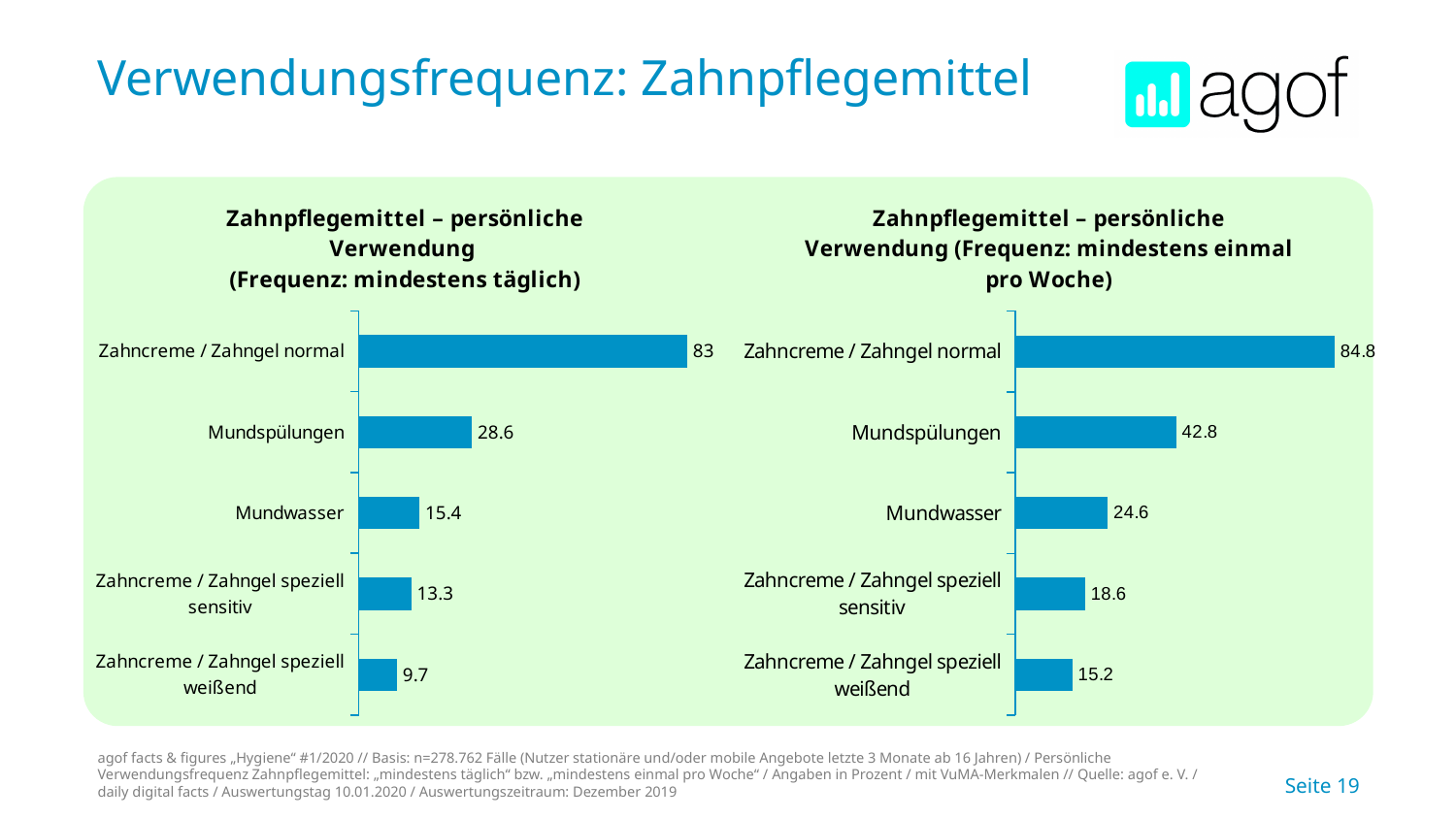
In the right chart (Frequenz: mindestens einmal pro Woche), which category has the highest value? Zahncreme / Zahngel normal Which is larger: the value for Mundspülungen in the left chart or the value for Mundspülungen in the right chart? Right chart (42.8) In the left chart (Frequenz: mindestens täglich), what is the value for Zahncreme / Zahngel speziell weißend? 9.7 In the left chart (Frequenz: mindestens täglich), which category has the lowest value? Zahncreme / Zahngel speziell weißend In the left chart (Frequenz: mindestens täglich), what is the value for Mundspülungen? 28.6 In the left chart (Frequenz: mindestens täglich), what is the difference between Mundwasser and Zahncreme / Zahngel speziell sensitiv? 2.1 What type of chart is used on this slide? Bar chart In the right chart (Frequenz: mindestens einmal pro Woche), what is the value for Mundwasser? 24.6 In the right chart (Frequenz: mindestens einmal pro Woche), what is the difference between Zahncreme / Zahngel normal and Mundspülungen? 42 What is the title of the right chart? Zahnpflegemittel – persönliche Verwendung (Frequenz: mindestens einmal pro Woche) In the right chart (Frequenz: mindestens einmal pro Woche), what is the value for Zahncreme / Zahngel speziell sensitiv? 18.6 How many categories does the left chart (Frequenz: mindestens täglich) show? 5